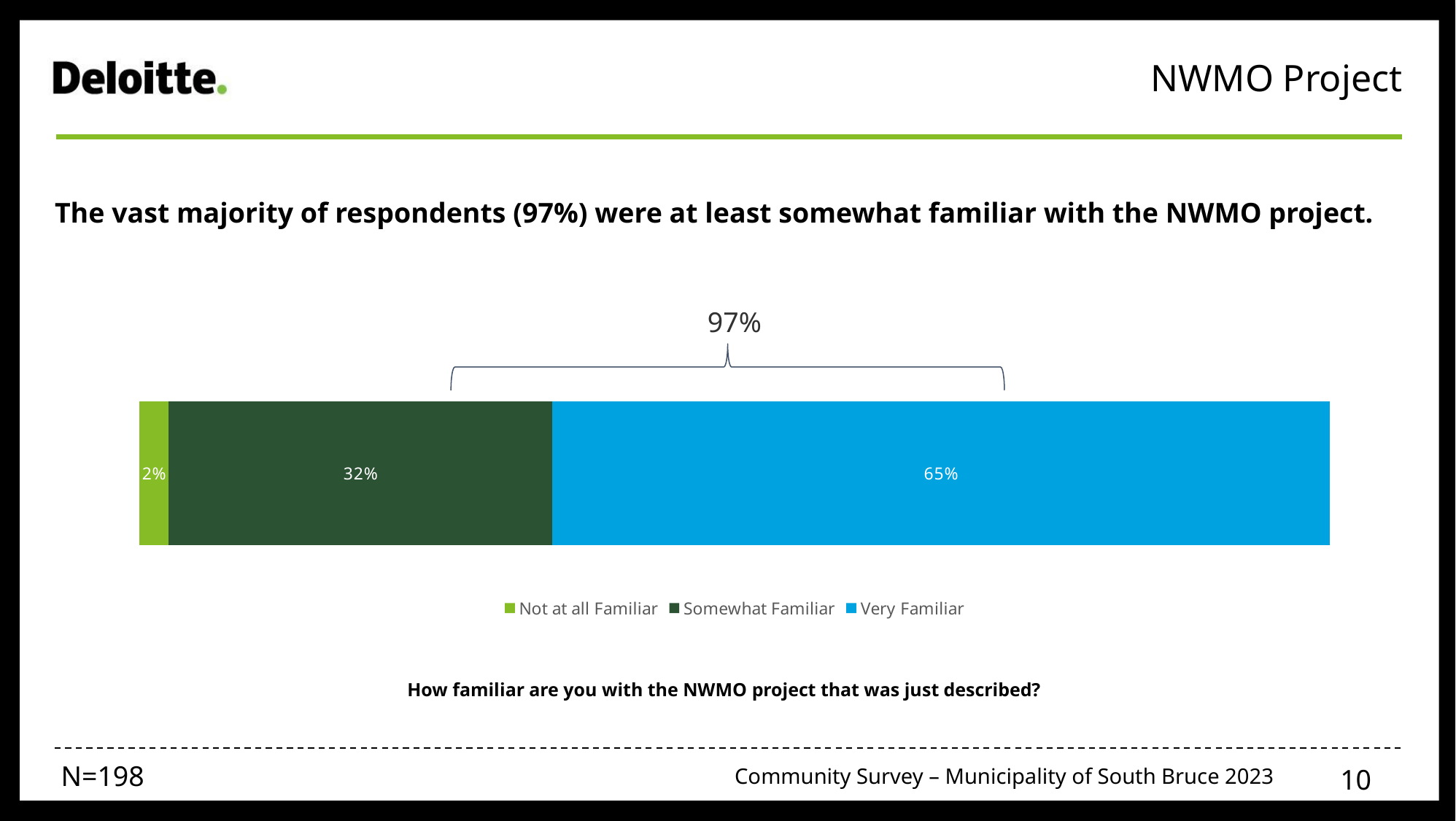
What percentage of respondents were Very Familiar with the NWMO project? 65% What is the difference in percentage points between Very Familiar and Somewhat Familiar? 33 What percentage of respondents were Somewhat Familiar with the NWMO project? 32% What survey question does the chart answer? How familiar are you with the NWMO project that was just described? What percentage of respondents were Not at all Familiar with the NWMO project? 2% How many series does the legend list? 3 What kind of chart is shown on the slide? Stacked bar chart Which familiarity category has the smallest share of respondents? Not at all Familiar What combined percentage of respondents were at least somewhat familiar (Somewhat Familiar plus Very Familiar), as labelled by the bracket? 97% Which familiarity category has the largest share of respondents? Very Familiar What colour represents the Very Familiar series in the chart? Blue Which is larger: the share of Somewhat Familiar or Not at all Familiar respondents? Somewhat Familiar